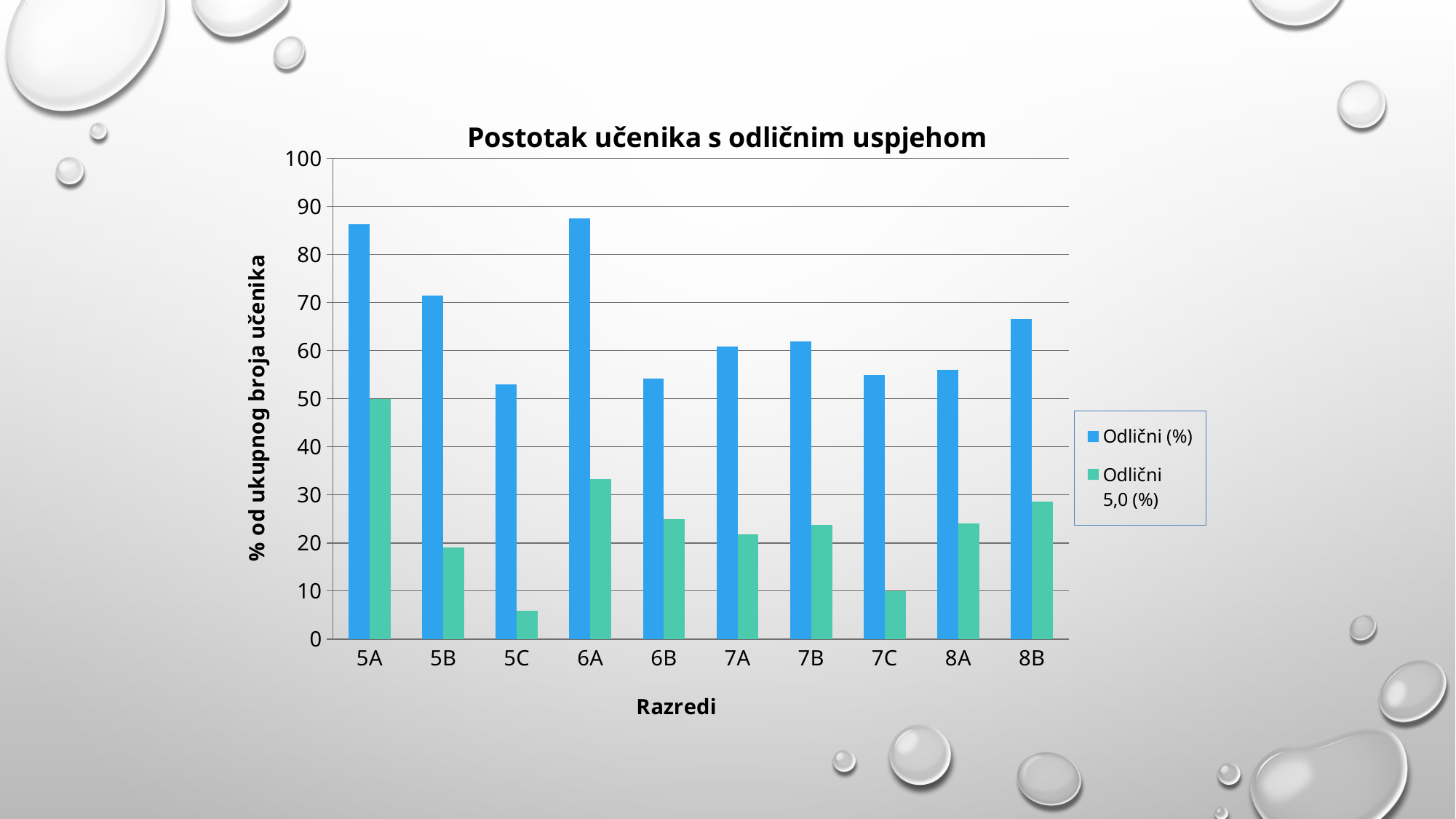
Is the Odlični (%) value for 5A greater or less than 80? greater Which class has the lowest value for the Odlični 5,0 (%) series? 5C Which class has the larger Odlični 5,0 (%) value, 6A or 6B? 6A What is the label of the x axis? Razredi How many series does the legend list? 2 Is the Odlični 5,0 (%) value for 5C greater or less than 10? less How many classes (categories) are shown on the x axis? 10 Which class has the larger Odlični (%) value, 5B or 5C? 5B Is the Odlični (%) value for 8B greater or less than 60? greater Which class has the highest value for the Odlični 5,0 (%) series? 5A What is the title of the chart? Postotak učenika s odličnim uspjehom What kind of chart is shown on the slide? bar chart